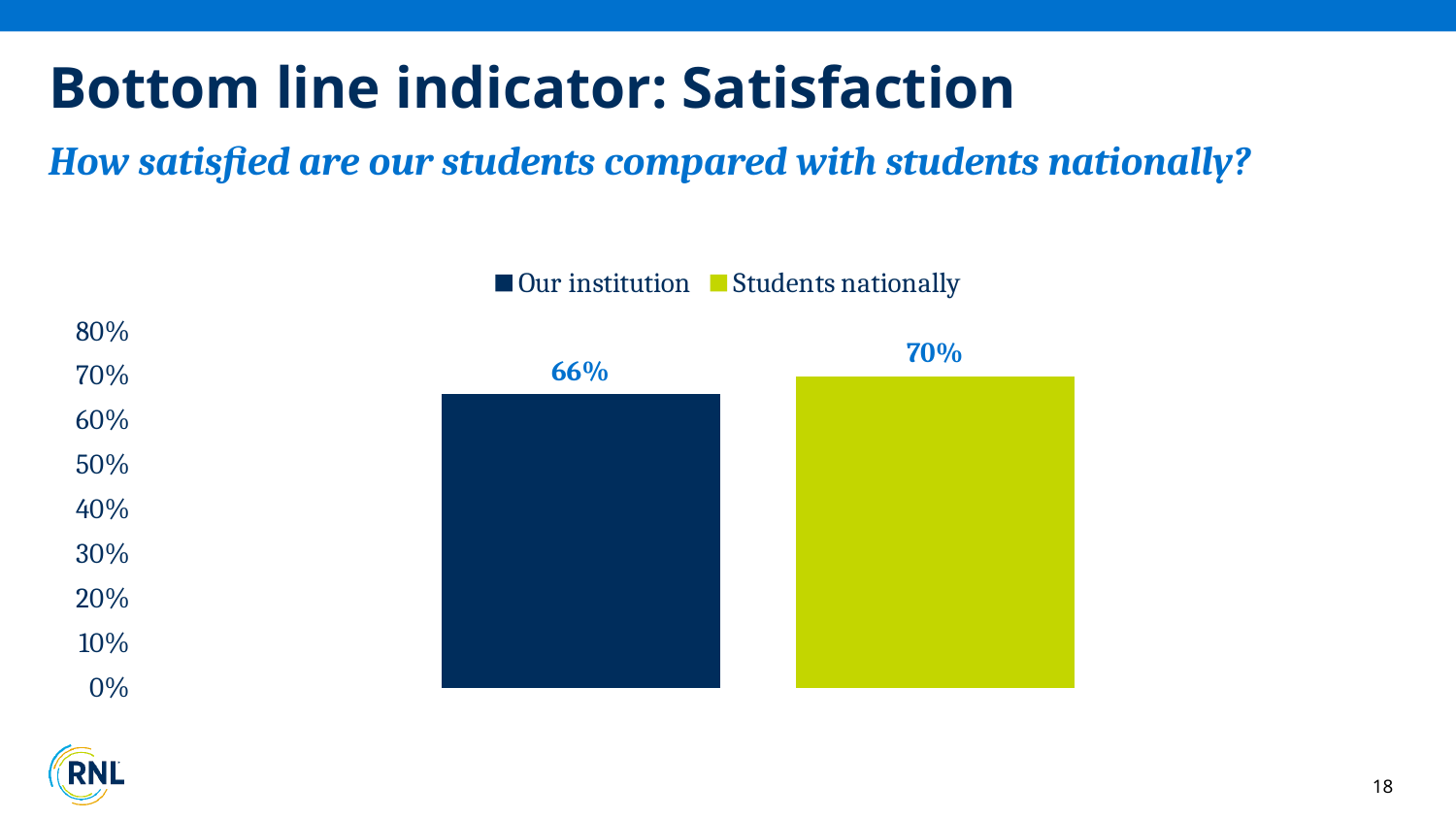
How many bars are plotted on the chart? 2 Is the value for Our institution greater or less than 50%? greater Is the value for Our institution larger or smaller than the value for Students nationally? smaller What is the satisfaction value for Students nationally? 70% Is the value for Students nationally greater or less than 80%? less Which series has the higher satisfaction value? Students nationally What kind of chart is shown on the slide? bar chart What is the highest value shown on the vertical axis? 80% What is the satisfaction value for Our institution? 66% What is the difference between the Students nationally value and the Our institution value? 4% Which series has the lower satisfaction value? Our institution How many series does the legend list? 2